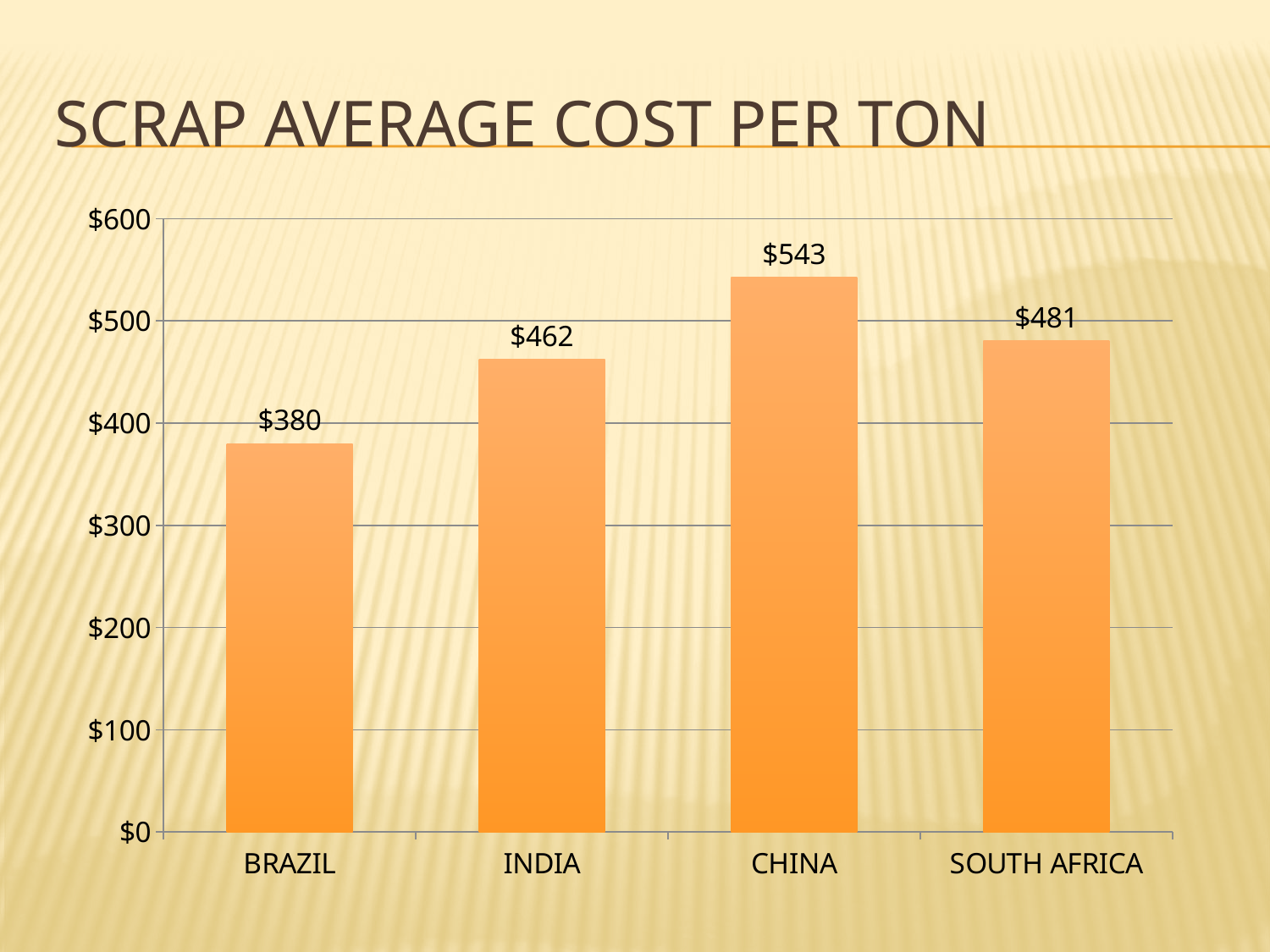
What is the title of the slide? Scrap Average Cost Per Ton What is the scrap average cost per ton for South Africa? $481 Which country has the lowest scrap average cost per ton? Brazil What is the scrap average cost per ton for China? $543 Which country has the highest scrap average cost per ton? China What is the difference between the scrap cost per ton for China and India? $81 What is the difference between the scrap cost per ton for South Africa and Brazil? $101 Is the value for India greater or less than $500? less What is the scrap average cost per ton for Brazil? $380 What kind of chart is shown on the slide? Bar chart Which has a higher scrap average cost per ton, India or South Africa? South Africa How many countries are shown in the chart? 4